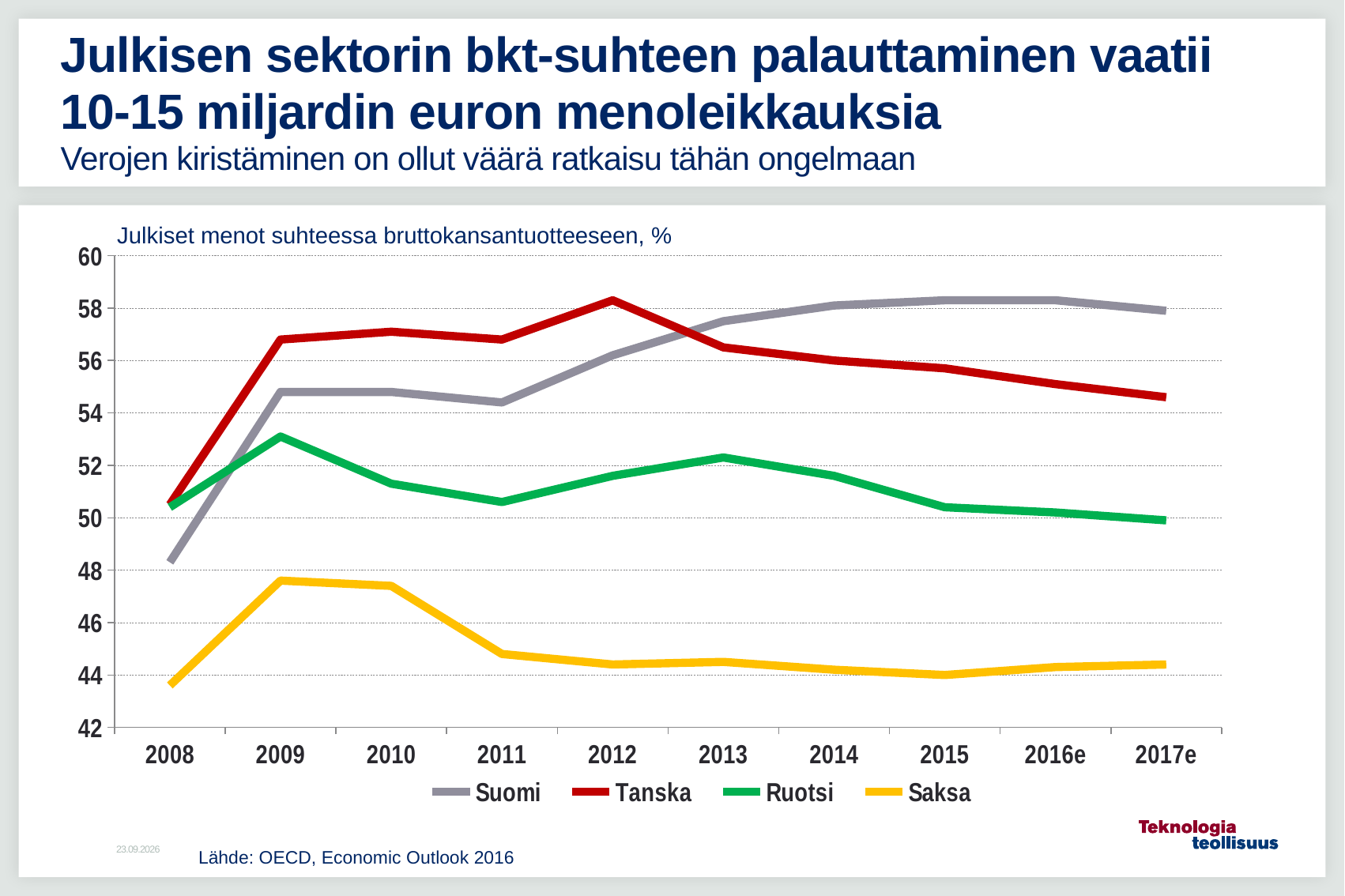
Does the value for Tanska rise or fall from 2012 to 2017e? fall Is the value for Tanska in 2012 greater or less than 58? greater Which series has the lowest value in 2017e? Saksa Which series has the highest value in 2012? Tanska How many years are shown on the x axis? 10 Is the value for Suomi in 2008 greater or less than 50? less Which is larger in 2009, the value for Tanska or the value for Suomi? Tanska What is the title of the chart? Julkiset menot suhteessa bruttokansantuotteeseen, % What kind of chart is shown on the slide? line chart Which series has the highest value in 2017e? Suomi How many series does the legend list? 4 Is the value for Saksa in 2008 greater or less than 44? less